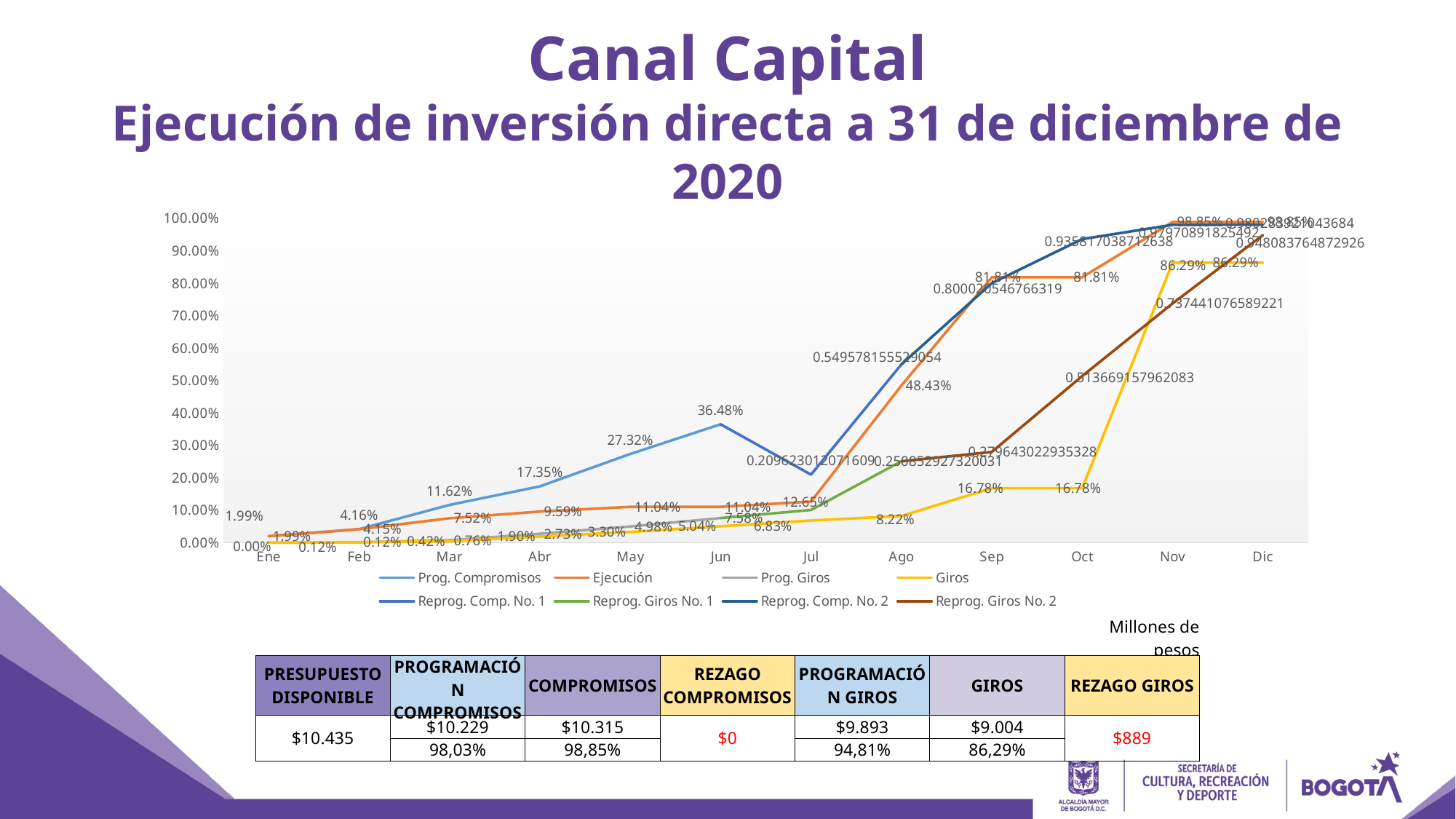
What is the value of Prog. Compromisos in Jun? 36.48% How many series does the chart legend list? 8 What is the title of the slide above the chart? Canal Capital Ejecución de inversión directa a 31 de diciembre de 2020 What is the difference between Ejecución and Giros in Sep? 65.03% What is the value of Ejecución in Sep? 81.81% Which is larger in Sep, Ejecución or Giros? Ejecución What is the value of Giros in Nov? 86.29% Does the Ejecución series generally rise or fall from Ene to Dic? rise What kind of chart is shown on the slide? line chart How many months are shown along the x axis of the chart? 12 Is the value of Reprog. Comp. No. 2 in Ago greater or less than 50.00%? greater What is the value of Prog. Compromisos in May? 27.32%